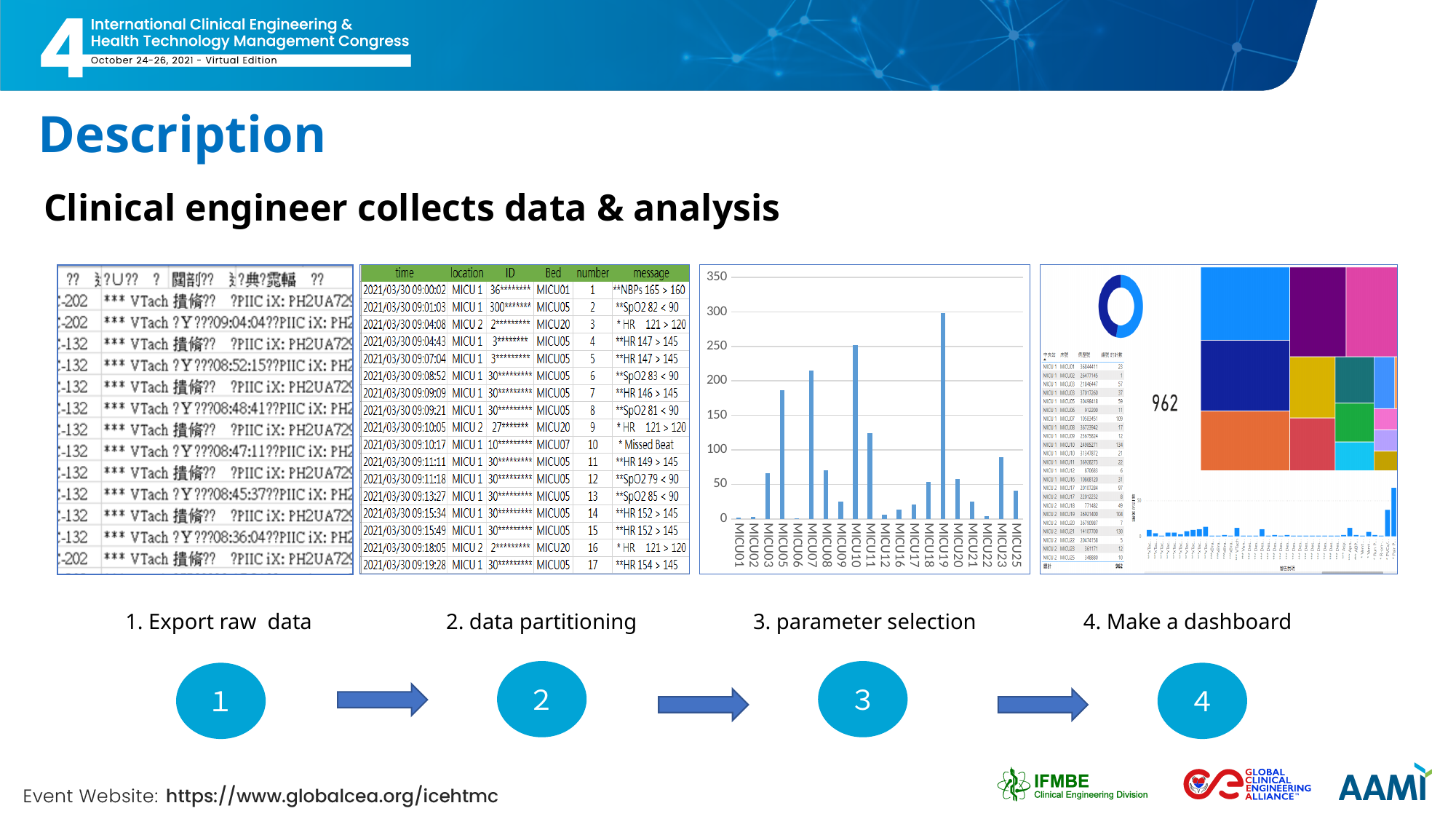
In the '3. parameter selection' bar chart, is the value for MICU03 greater or less than 200? less In the '3. parameter selection' bar chart, which is larger, the value for MICU07 or the value for MICU03? MICU07 In the '3. parameter selection' bar chart, is the value for MICU07 greater or less than 200? greater In the '3. parameter selection' bar chart, is the value for MICU09 greater or less than 50? less In the '3. parameter selection' bar chart, which category has the highest bar? MICU19 In the '3. parameter selection' bar chart, how many MICU categories are shown on the x axis? 20 In the '3. parameter selection' bar chart, what is the highest value shown on the y axis? 350 In the '3. parameter selection' bar chart, which is larger, the value for MICU19 or the value for MICU10? MICU19 In the '3. parameter selection' panel, what kind of chart is shown? bar chart